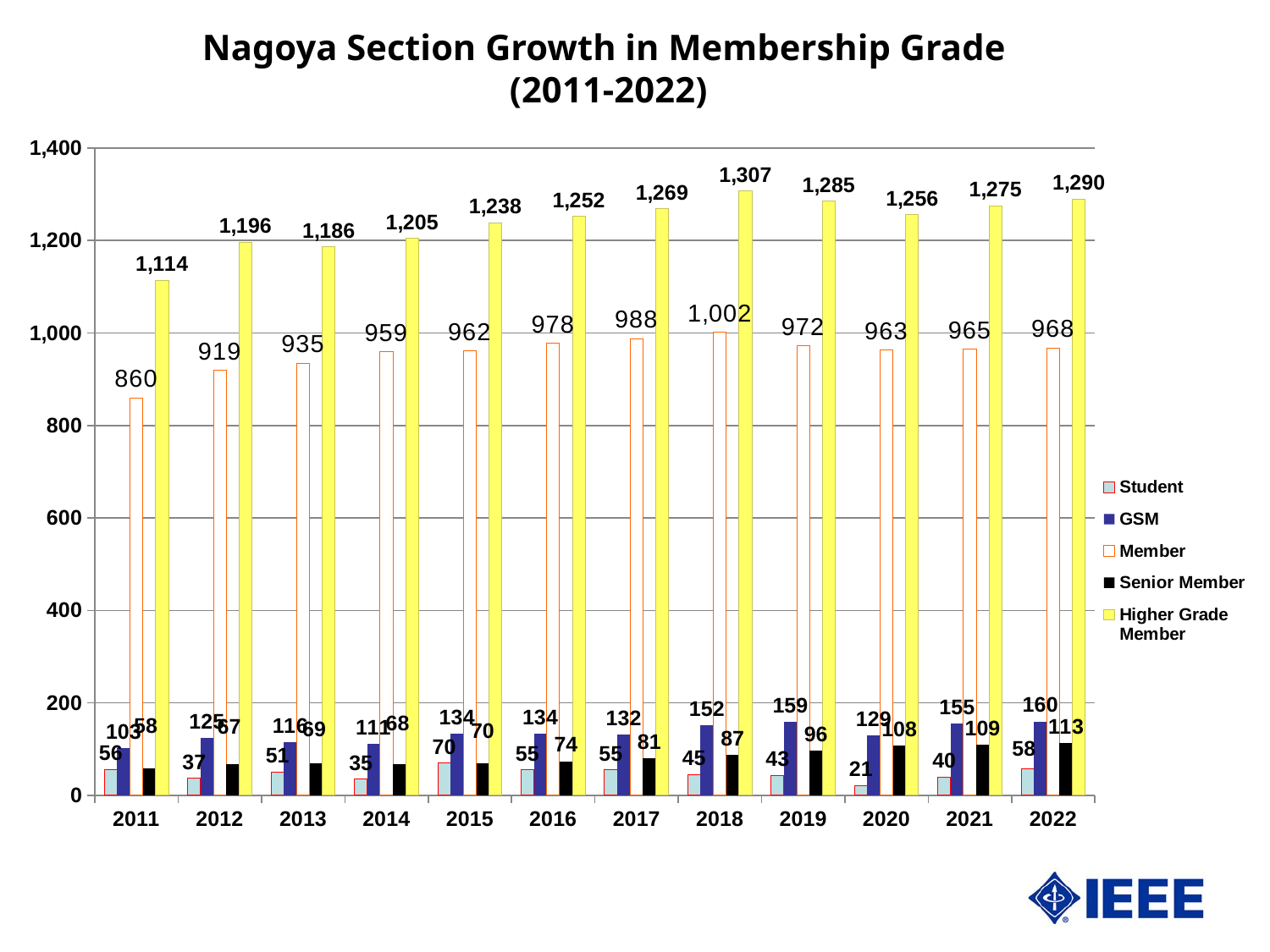
How many years are shown on the x axis? 12 What is the difference between the Higher Grade Member values for 2022 and 2011? 176 What is the value for Higher Grade Member in 2011? 1,114 What is the value for Member in 2018? 1,002 What is the value for GSM in 2019? 159 How many series does the legend list? 5 In which year is the Higher Grade Member value highest? 2018 What kind of chart is shown on the slide? bar chart In which year is the Student value lowest? 2020 What is the value for Senior Member in 2022? 113 Which is larger, the Member value for 2019 or for 2020? 2019 Does the Senior Member value generally rise or fall from 2011 to 2022? rise